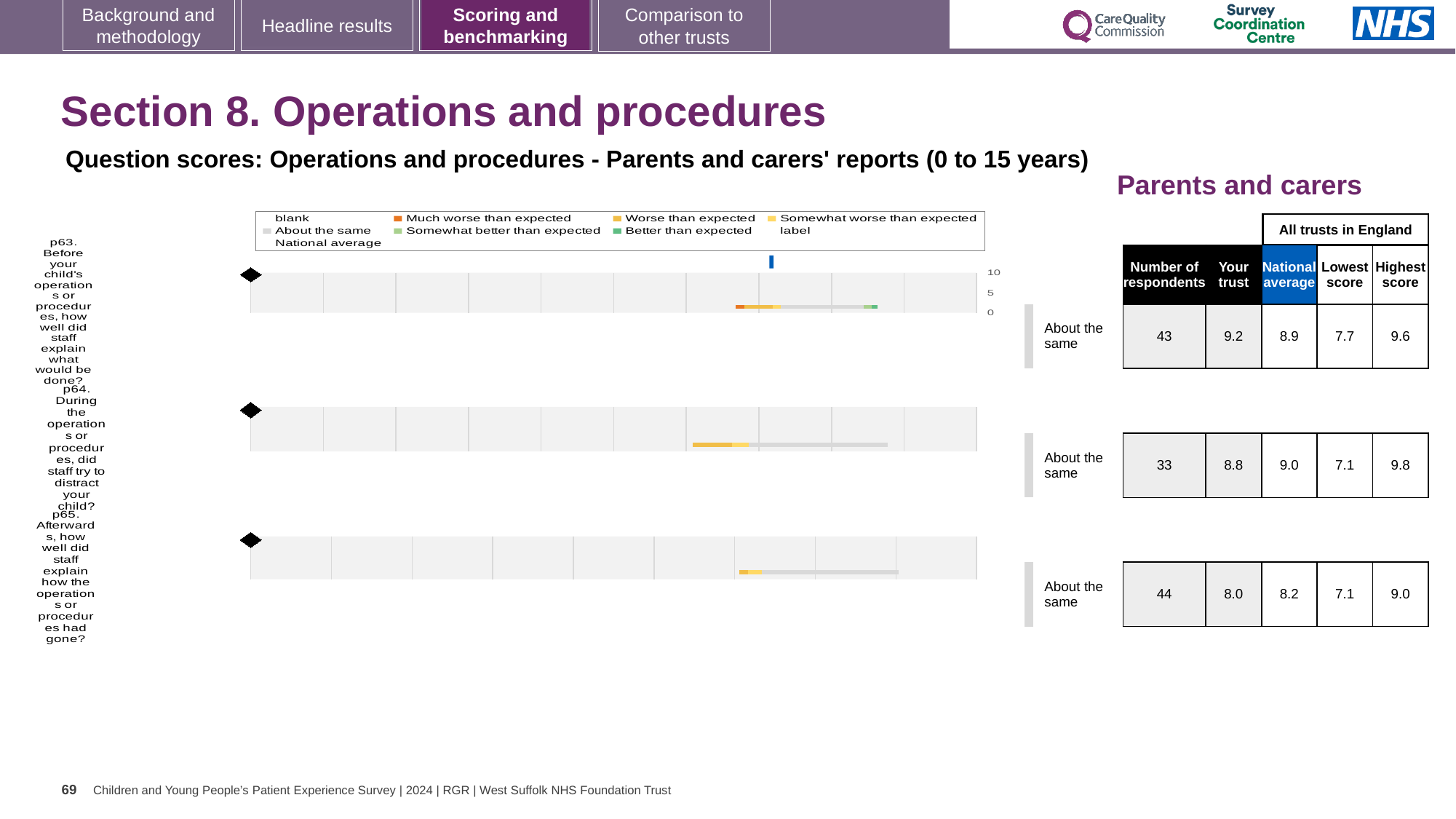
For p64, which is larger: the 'Your trust' score or the national average? National average What is the 'Your trust' score for p63 (how well staff explained what would be done before the operation)? 9.2 How many questions (p63, p64, p65) are plotted on the slide? 3 What benchmark category is shown for p65? About the same What is the national average score for p64 (did staff try to distract your child during the operation)? 9.0 For p63, what is the difference between the highest score (9.6) and the lowest score (7.7) across all trusts in England? 1.9 What kind of chart is used to show the question scores on this slide? bar chart Which question has the lowest 'Your trust' score? p65 What does the blue marker in the chart legend represent? National average How many respondents answered p65 (how well staff explained how the operation had gone)? 44 Which question has the highest 'Your trust' score? p63 In the chart legend, what does the orange colour represent? Much worse than expected